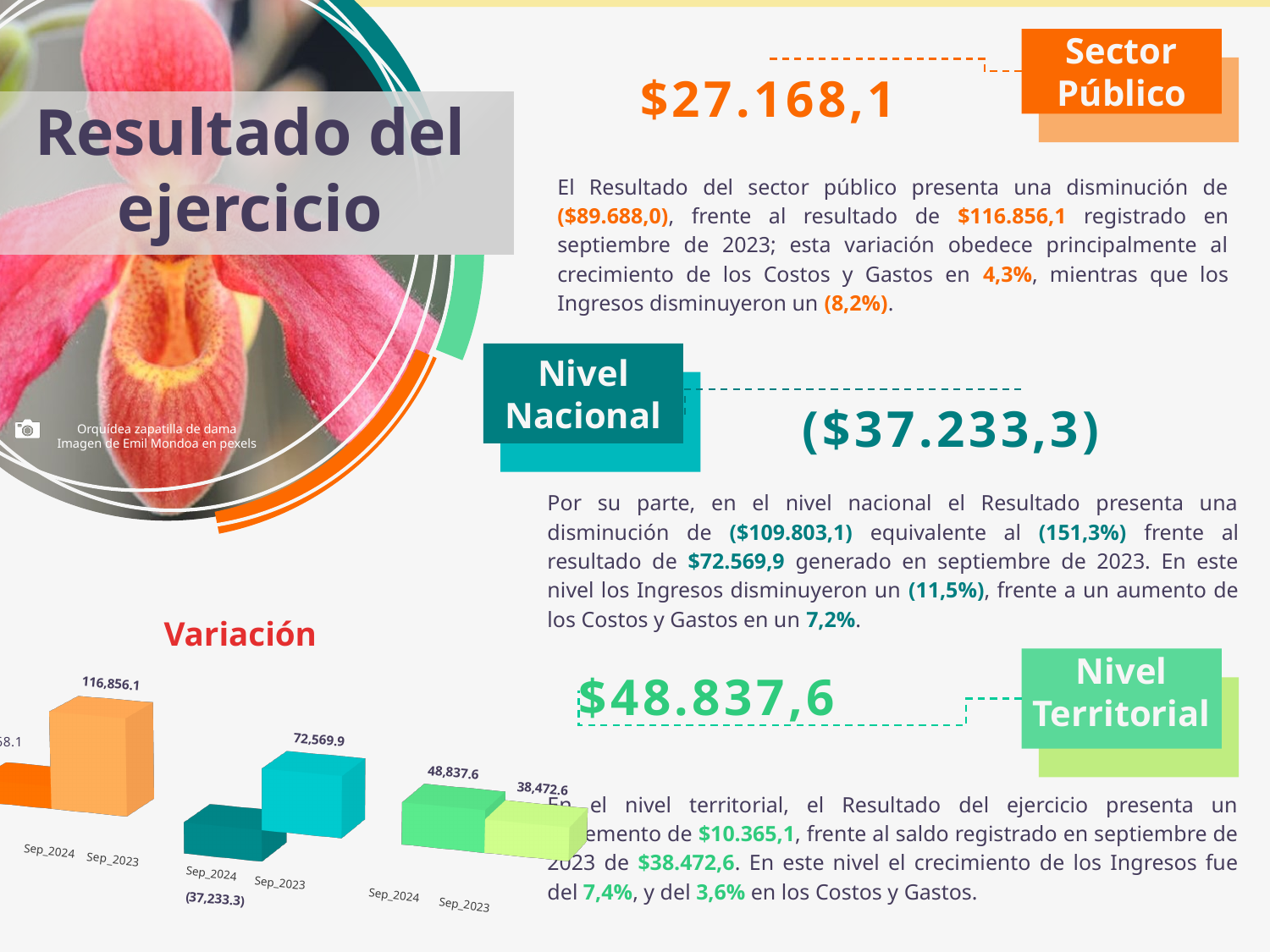
How many groups of bars are shown in the "Variación" chart? 3 In the "Variación" chart, what is the highest labelled value? 116,856.1 In the "Variación" chart, what is the Sep_2024 value in the teal (middle) group of bars? (37,233.3) In the "Variación" chart, which period has the larger value in the green (right) group, Sep_2024 or Sep_2023? Sep_2024 In the "Variación" chart, what is the difference between the Sep_2024 and Sep_2023 values in the green (right) group? 10,365.0 In the "Variación" chart, what is the Sep_2023 value in the green (right) group of bars? 38,472.6 In the "Variación" chart, which period has the larger value in the teal (middle) group, Sep_2024 or Sep_2023? Sep_2023 What is the title of the chart in the lower left of the slide? Variación In the "Variación" chart, what is the Sep_2023 value in the orange group of bars? 116,856.1 In the "Variación" chart, what is the Sep_2023 value in the teal (middle) group of bars? 72,569.9 What kind of chart is shown under the heading "Variación"? bar chart In the "Variación" chart, what is the Sep_2024 value in the green (right) group of bars? 48,837.6